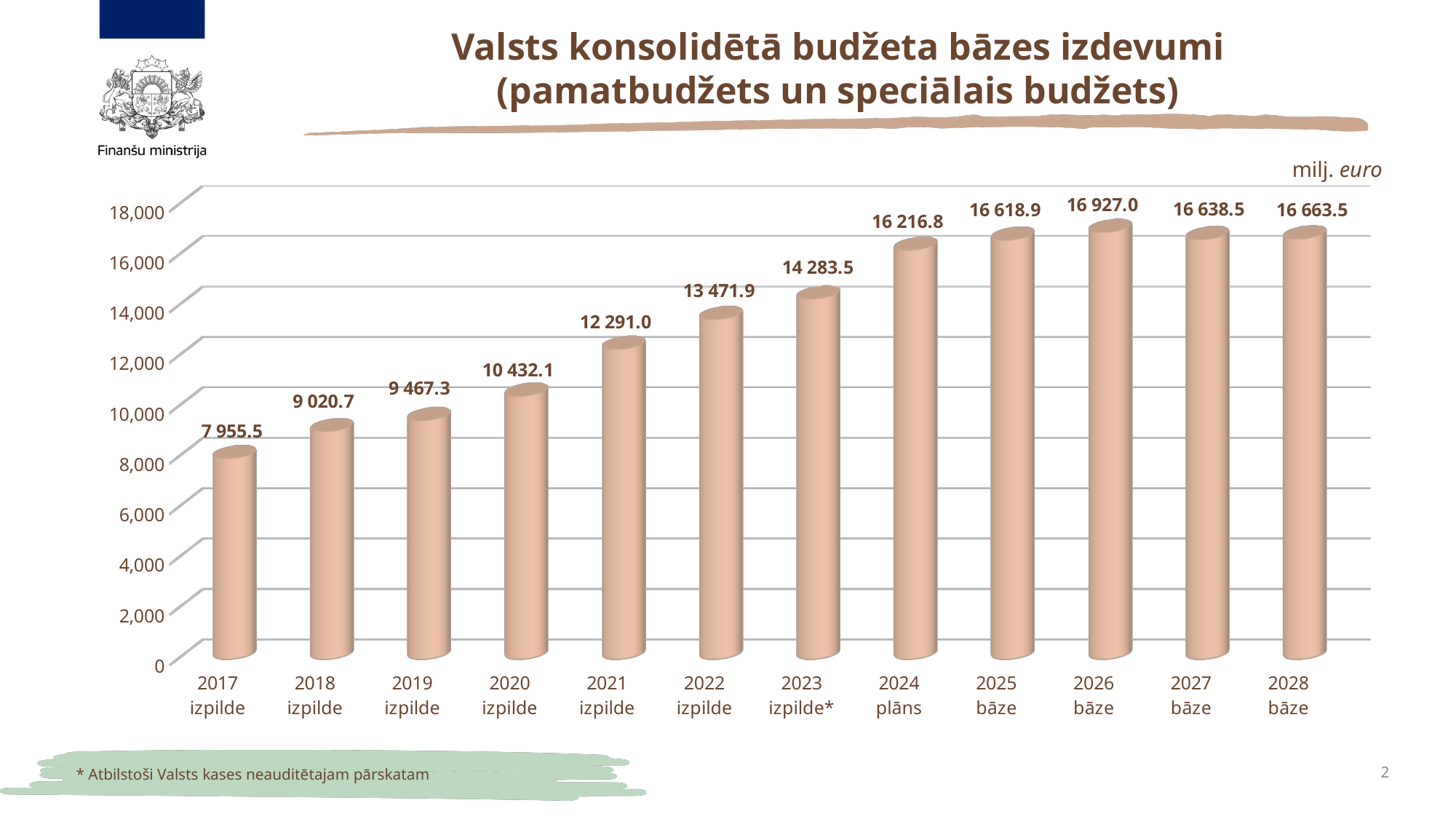
What is the difference between the values for 2028 bāze and 2027 bāze? 25.0 What is the value for 2028 bāze? 16 663.5 What unit is indicated for the values in the chart? milj. euro Do the values rise or fall from 2017 izpilde to 2024 plāns? rise What is the value for 2024 plāns? 16 216.8 What is the value for 2017 izpilde? 7 955.5 Which year has the highest value in the chart? 2026 bāze Which year has the lowest value in the chart? 2017 izpilde How many bars (years) are plotted in the chart? 12 Which is larger, the value for 2021 izpilde or 2022 izpilde? 2022 izpilde What type of chart is shown on the slide? bar chart What is the difference between the values for 2024 plāns and 2023 izpilde*? 1 933.3